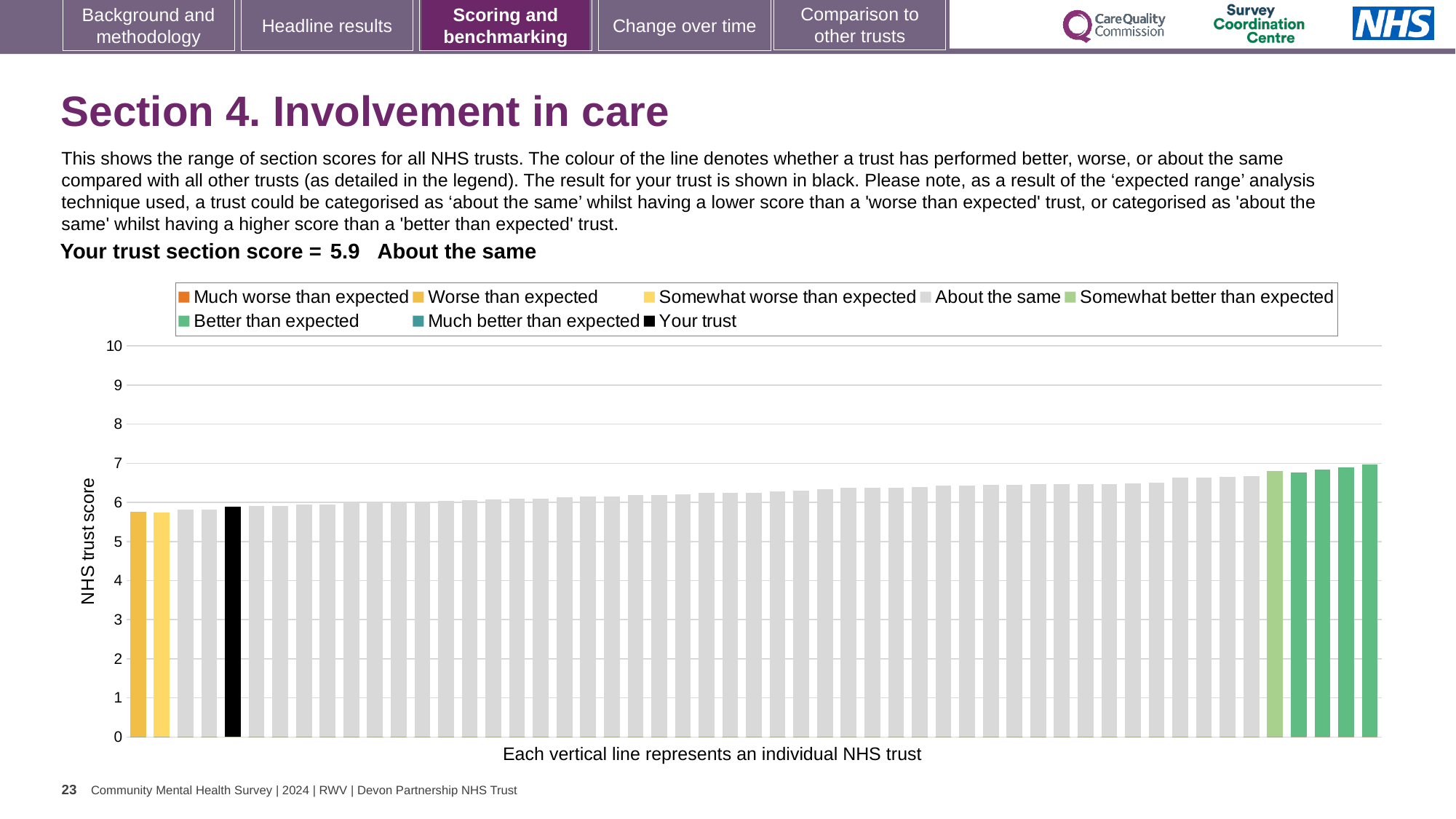
What is the section score for your trust shown on the slide? 5.9 How many entries does the chart legend list? 8 Is the value of the leftmost (lowest) bar greater or less than 5? greater What is the label on the vertical axis of the chart? NHS trust score Which performance category is your trust's section score placed in? About the same Do the bar values rise or fall from left to right along the x axis? rise Is the value for your trust (the black bar) greater or less than 5? greater How many bars are coloured in the dark green 'Better than expected' colour? 4 What colour is the bar representing your trust? black Is the value for your trust (the black bar) greater or less than 6? less What kind of chart is shown on the slide? bar chart